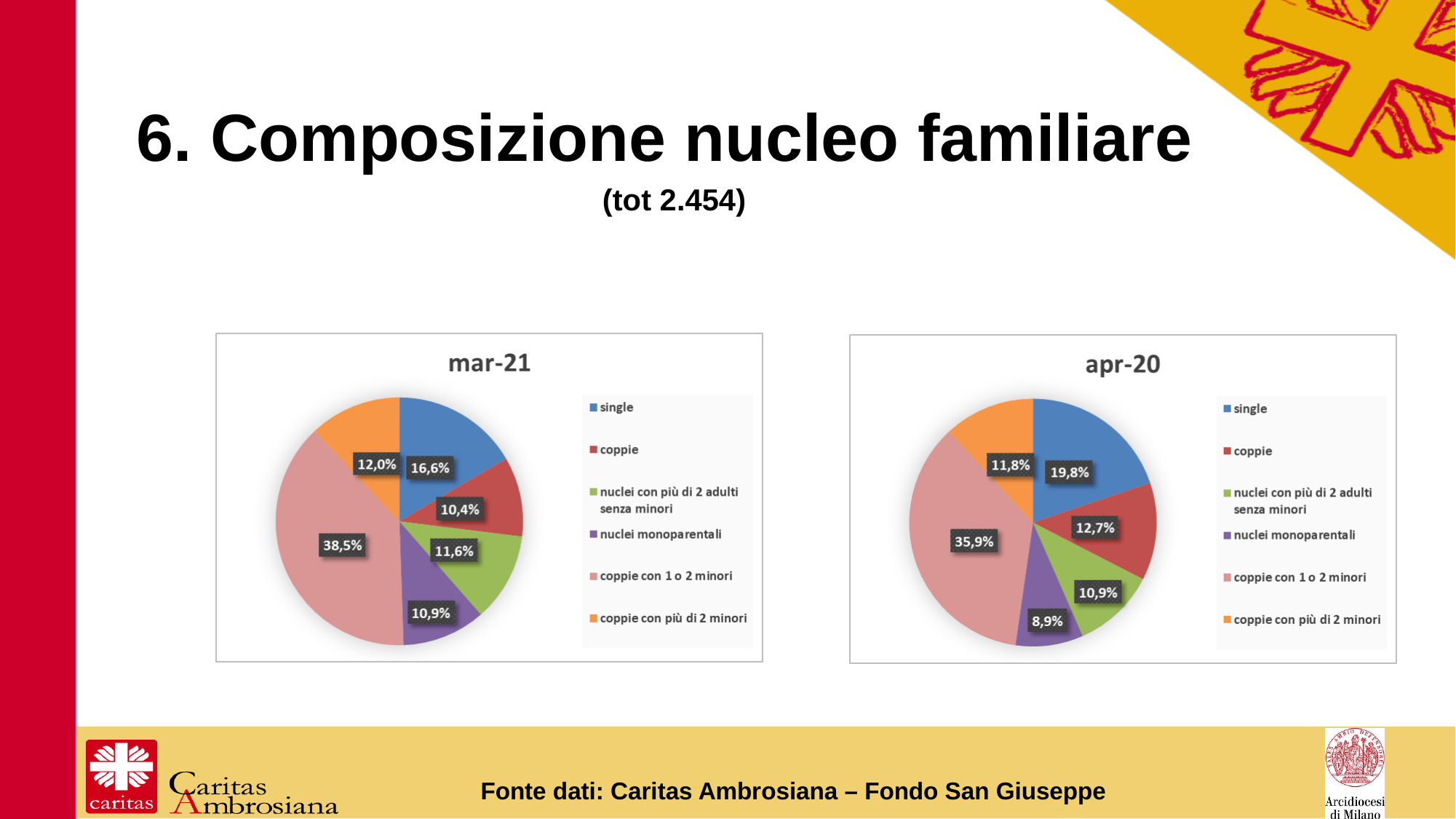
In the apr-20 chart, what share is labelled for 'single'? 19,8% Which chart shows a larger share for 'single', mar-21 or apr-20? apr-20 In the apr-20 chart, which category has the largest slice? coppie con 1 o 2 minori In the mar-21 chart, what share is labelled for 'coppie con più di 2 minori'? 12,0% In the apr-20 chart, what share is labelled for 'nuclei monoparentali'? 8,9% In the mar-21 chart, what is the difference between the 'coppie con 1 o 2 minori' share and the 'single' share? 21,9% In the apr-20 chart, which category has the smallest slice? nuclei monoparentali In the mar-21 chart, what share is labelled for 'coppie con 1 o 2 minori'? 38,5% How many categories does the legend of the mar-21 chart list? 6 In the apr-20 chart, what is the difference between the 'coppie' share and the 'nuclei monoparentali' share? 3,8% What type of chart is the apr-20 chart? pie chart In the mar-21 chart, which category has the smallest slice? coppie